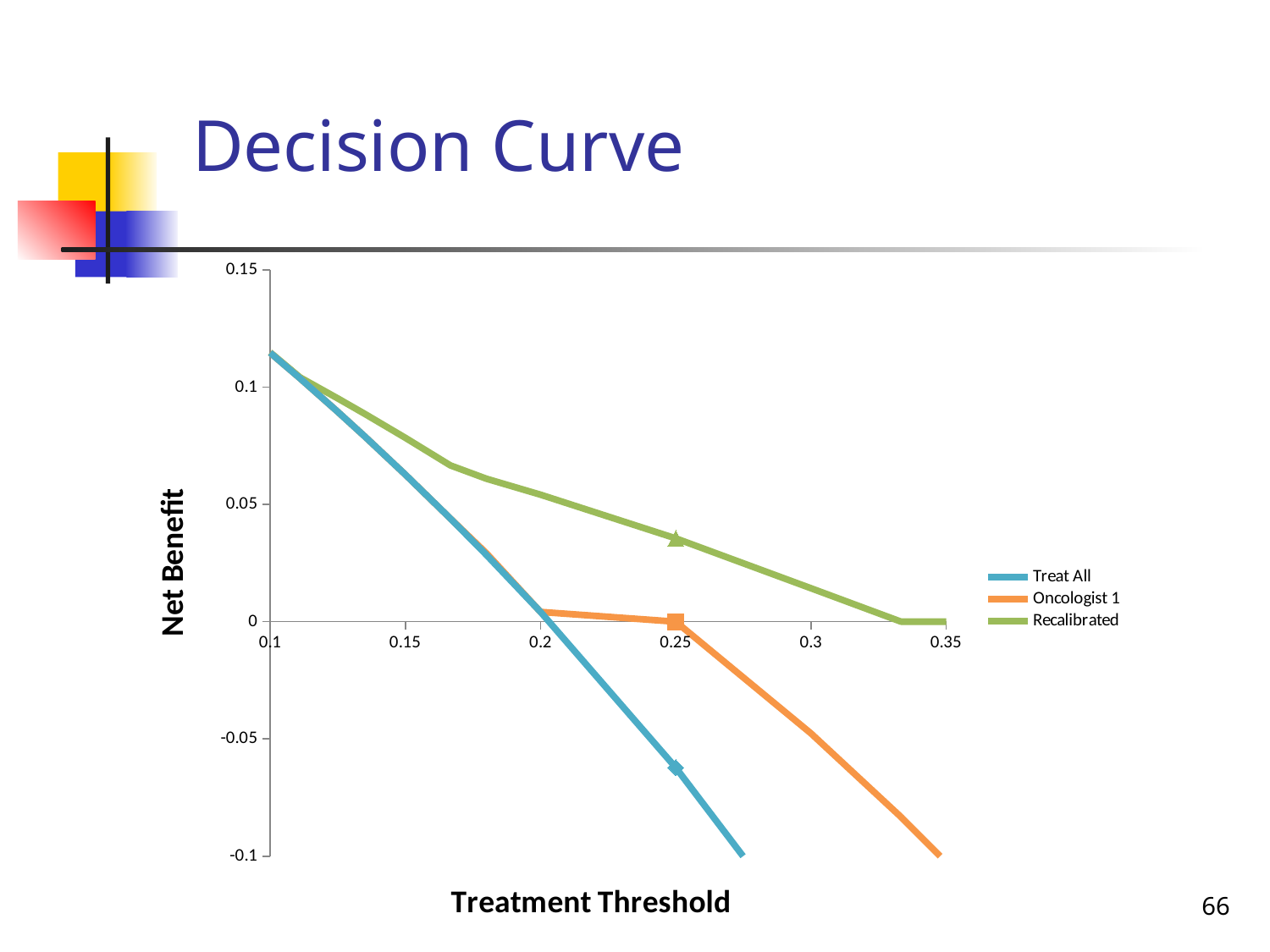
Is the Net Benefit for Recalibrated at a Treatment Threshold of 0.25 greater or less than 0.05? less What kind of chart is shown on the slide? line chart At a Treatment Threshold of 0.25, which series has the highest Net Benefit? Recalibrated At a Treatment Threshold of 0.3, is the Net Benefit higher for Recalibrated or for Oncologist 1? Recalibrated At a Treatment Threshold of 0.3, which series has the lowest Net Benefit? Treat All How many series does the legend list? 3 Is the Net Benefit for Treat All at a Treatment Threshold of 0.25 greater or less than -0.05? less Is the Net Benefit for Recalibrated at a Treatment Threshold of 0.3 greater or less than 0? greater What is the label of the x axis? Treatment Threshold What are the series names listed in the legend? Treat All, Oncologist 1, Recalibrated Does the Net Benefit for Treat All rise or fall as the Treatment Threshold increases? fall